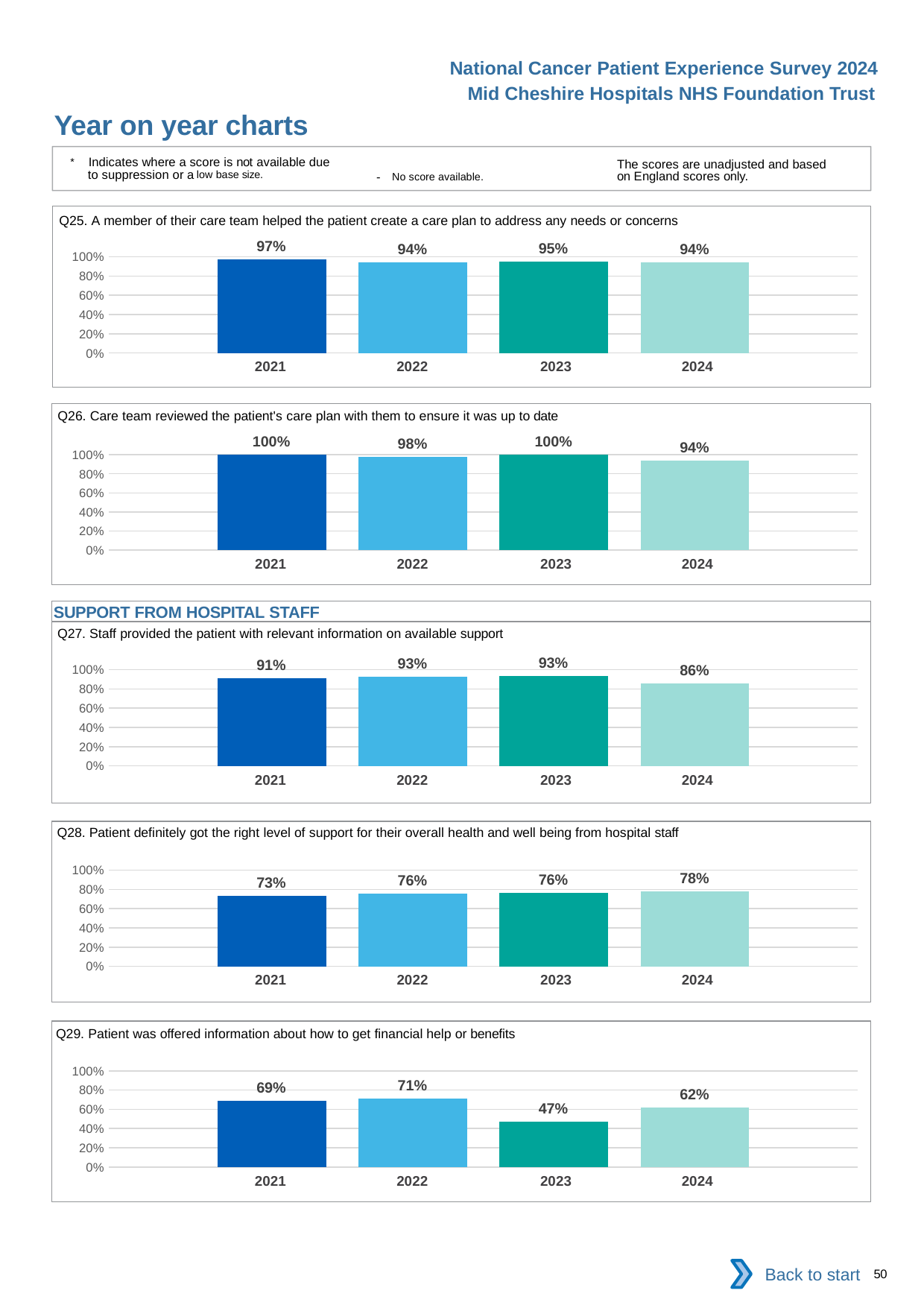
In the Q28 chart, how many years are plotted? 4 In the Q29 chart, what is the value for 2023? 47% In the Q27 chart, what is the difference between the 2023 and 2024 values? 7% In the Q28 chart, do the values rise or fall from 2021 to 2024? rise In the Q29 chart, which is larger, the value for 2022 or the value for 2024? 2022 In the Q25 chart, what is the value for 2021? 97% In the Q26 chart, which year has the lowest value? 2024 What kind of chart is the Q26 chart? bar chart In the Q26 chart, what is the value for 2022? 98% In the Q29 chart, what is the difference between the 2021 and 2023 values? 22% How many charts are shown on the slide? 5 In the Q28 chart, which year has the highest value? 2024